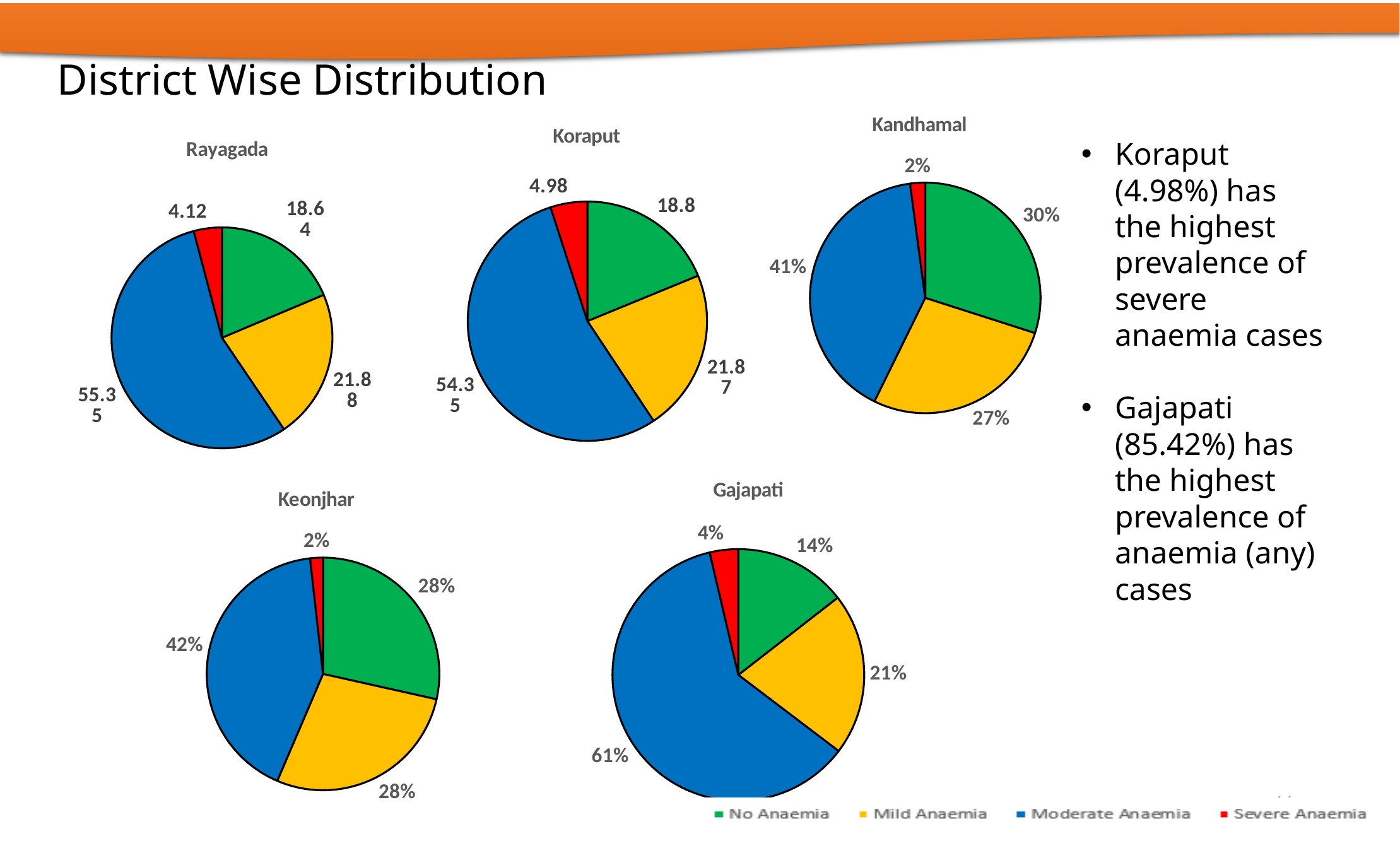
In the Koraput chart, what is the value for No Anaemia? 18.8 In the Koraput chart, what is the value for Severe Anaemia? 4.98 Which colour represents Mild Anaemia in the legend? Yellow In the Gajapati chart, what share of the pie is Moderate Anaemia? 61% What kind of charts are shown on the slide? Pie charts In the Rayagada chart, what is the value for Severe Anaemia? 4.12 In the Kandhamal chart, what is the difference between the Moderate Anaemia and Mild Anaemia values? 14% In the Gajapati chart, which category has the smallest slice? Severe Anaemia How many series does the legend list? 4 In the Keonjhar chart, which category has the largest slice? Moderate Anaemia In the Gajapati chart, which is larger, Mild Anaemia or No Anaemia? Mild Anaemia In the Kandhamal chart, what is the value for No Anaemia? 30%